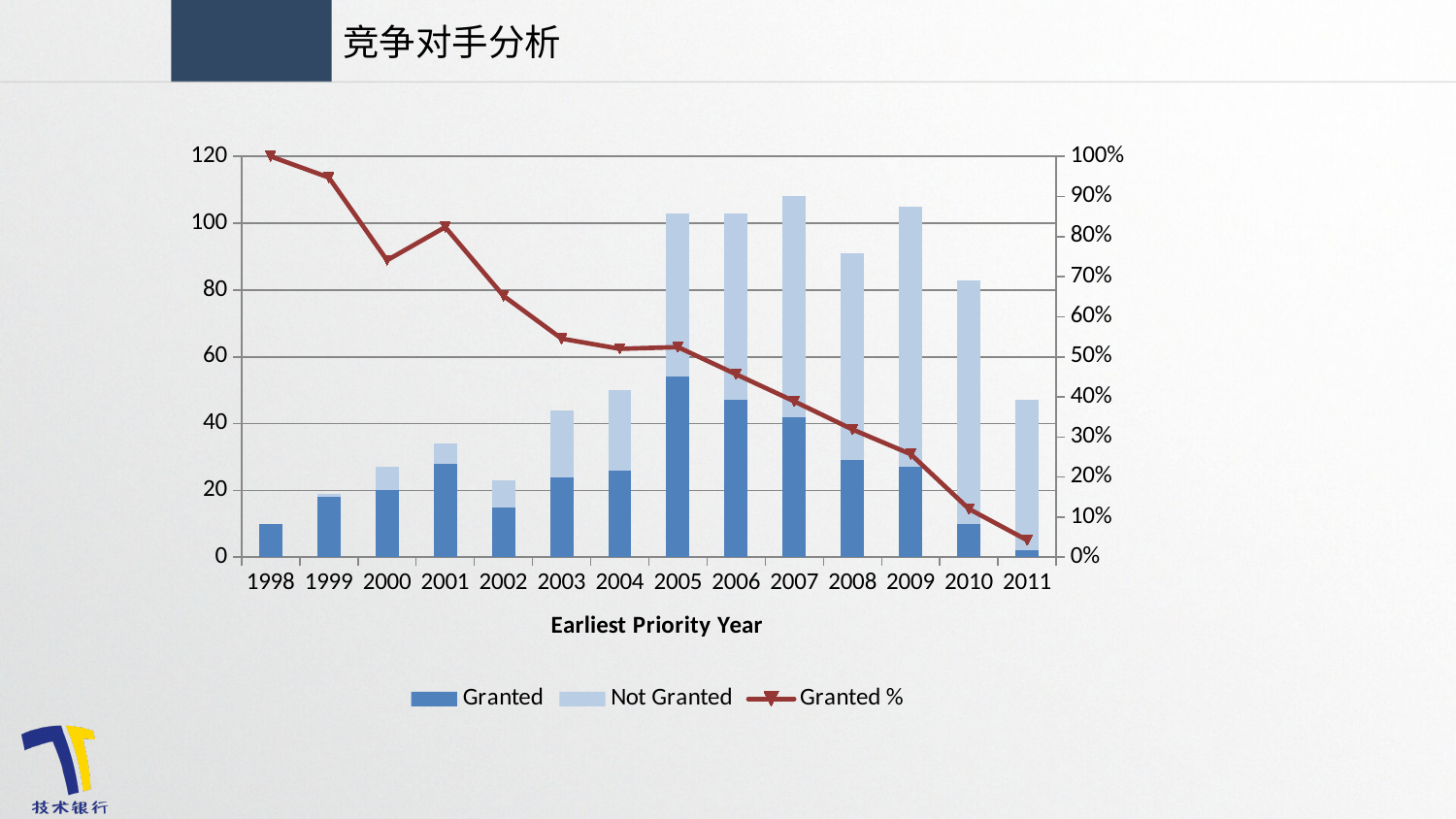
Which year has the lowest Granted value? 2011 How many years are shown on the x axis? 14 Is the Granted value for 2005 greater or less than 40? greater Which year has the highest Granted value? 2005 How many series does the legend list? 3 Which series is drawn as a line? Granted % Does the Granted % line generally rise or fall from 1998 to 2011? Fall Is the Granted % value for 2011 greater or less than 10%? less What kind of chart is shown on the slide? A bar chart with a line Which year has the lowest total stacked bar? 1998 What is the x-axis title of the chart? Earliest Priority Year Is the Granted value for 2005 larger or smaller than the Granted value for 2006? larger